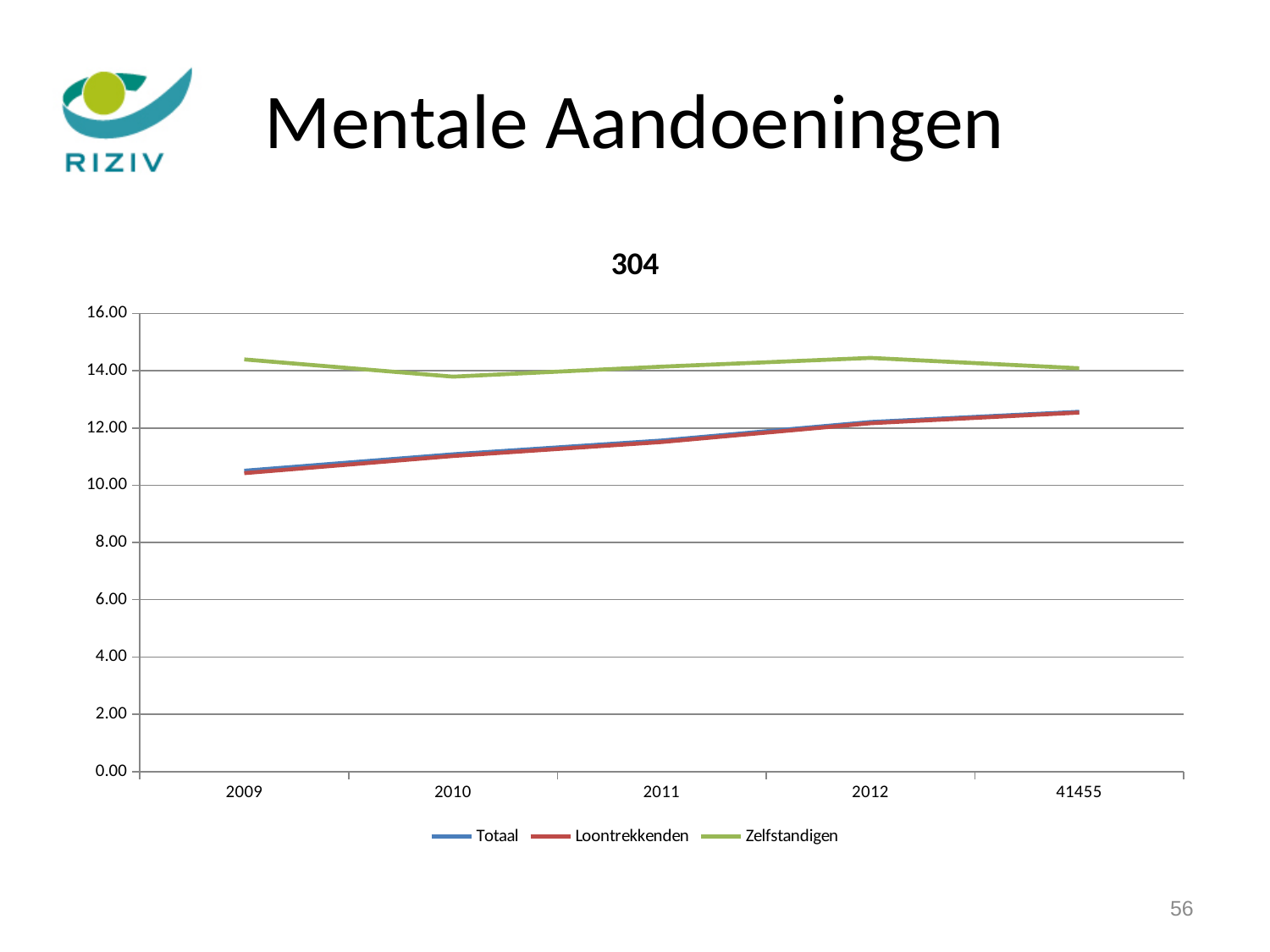
Does the Loontrekkenden line rise or fall from 2009 to 41455? rises What kind of chart is shown on the slide? line chart Is the value for Zelfstandigen in 2010 greater or less than 14.00? less Is the value for Totaal in 2011 greater or less than 12.00? less How many points are plotted along the x axis for each series? 5 How many series does the legend list? 3 What is the title of the chart? 304 At which x-axis point is the Loontrekkenden value lowest? 2009 Is the value for Zelfstandigen in 2009 greater or less than 14.00? greater Which series is shown in green in the legend? Zelfstandigen In 2009, which is larger: Zelfstandigen or Loontrekkenden? Zelfstandigen Which series has the highest values across all years? Zelfstandigen